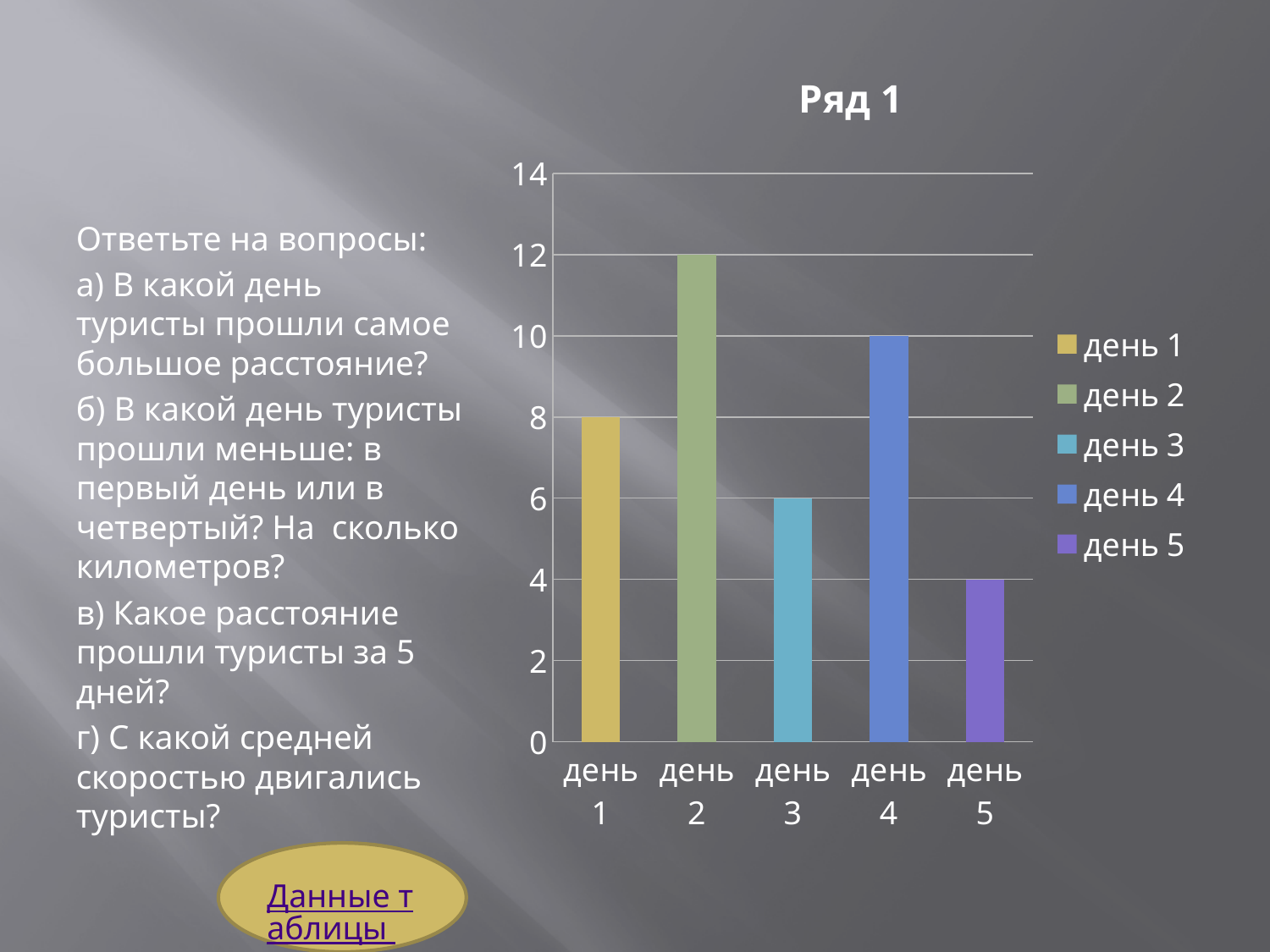
What is the value for день 1? 8 What kind of chart is shown on the slide? bar chart How many entries does the chart's legend list? 5 Is the value for день 3 greater or less than 8? less How many bars (categories) does the chart show? 5 What is the value for день 5? 4 What is the difference between the values for день 4 and день 1? 2 Which category has the lowest value? день 5 Which category has the highest value? день 2 What is the value for день 2? 12 What is the title of the chart? Ряд 1 Which is larger, the value for день 1 or the value for день 4? день 4